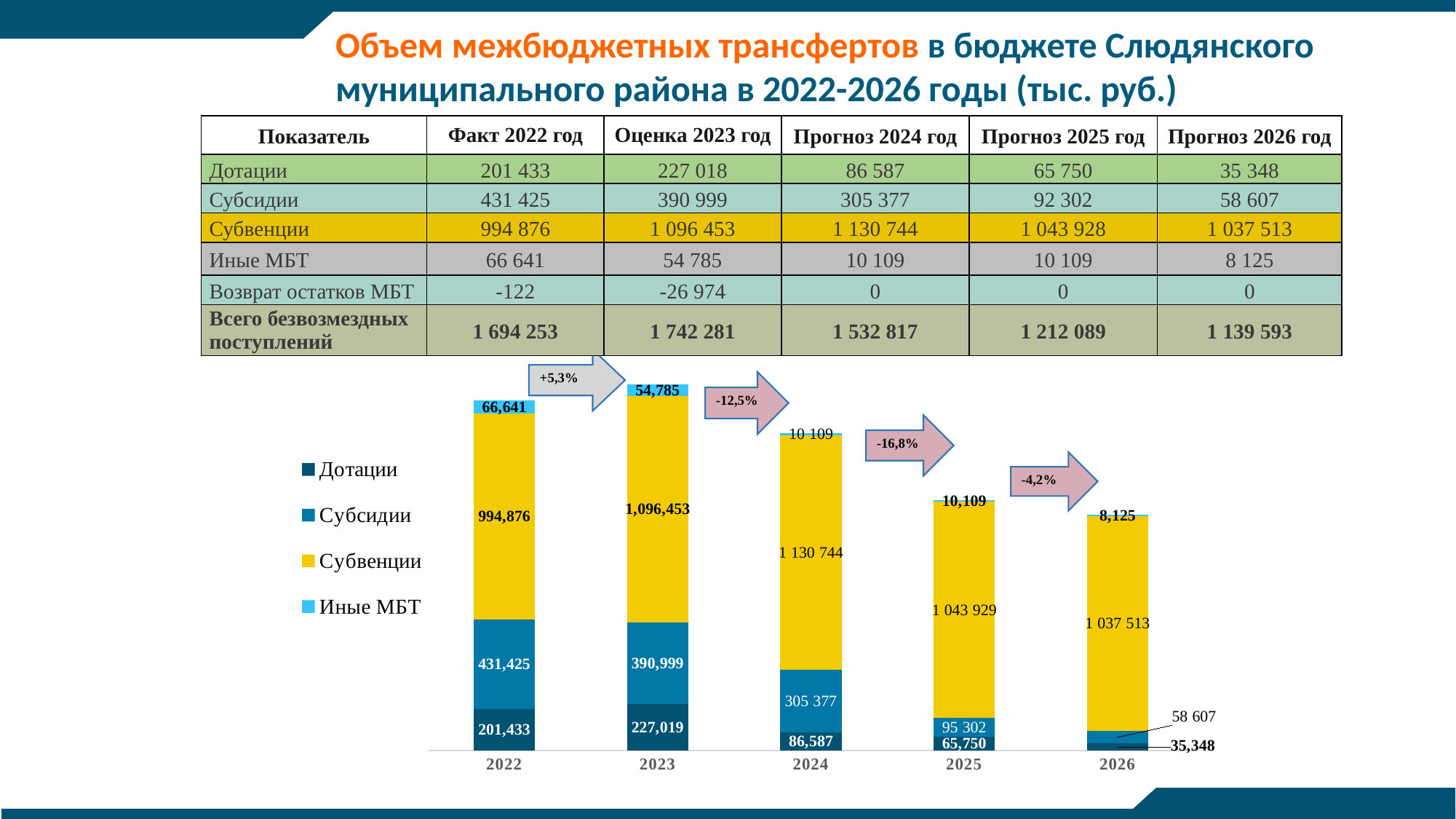
What percentage change is shown on the arrow between the 2023 and 2024 bars? -12,5% What is the value of Дотации for 2022 in the chart? 201,433 How many years are shown on the x axis of the chart? 5 How many series does the chart legend list? 4 What kind of chart is shown on the slide? stacked bar chart In which year is the Субсидии segment the largest in the chart? 2022 In which year is the Дотации segment the smallest in the chart? 2026 What is the value of Иные МБТ for 2026 in the chart? 8,125 Which is larger in the chart: Субвенции for 2024 or Субвенции for 2025? Субвенции for 2024 What is the difference between Иные МБТ for 2022 and Иные МБТ for 2023 in the chart? 11,856 What is the value of Субсидии for 2024 in the chart? 305 377 What is the value of Субвенции for 2023 in the chart? 1,096,453